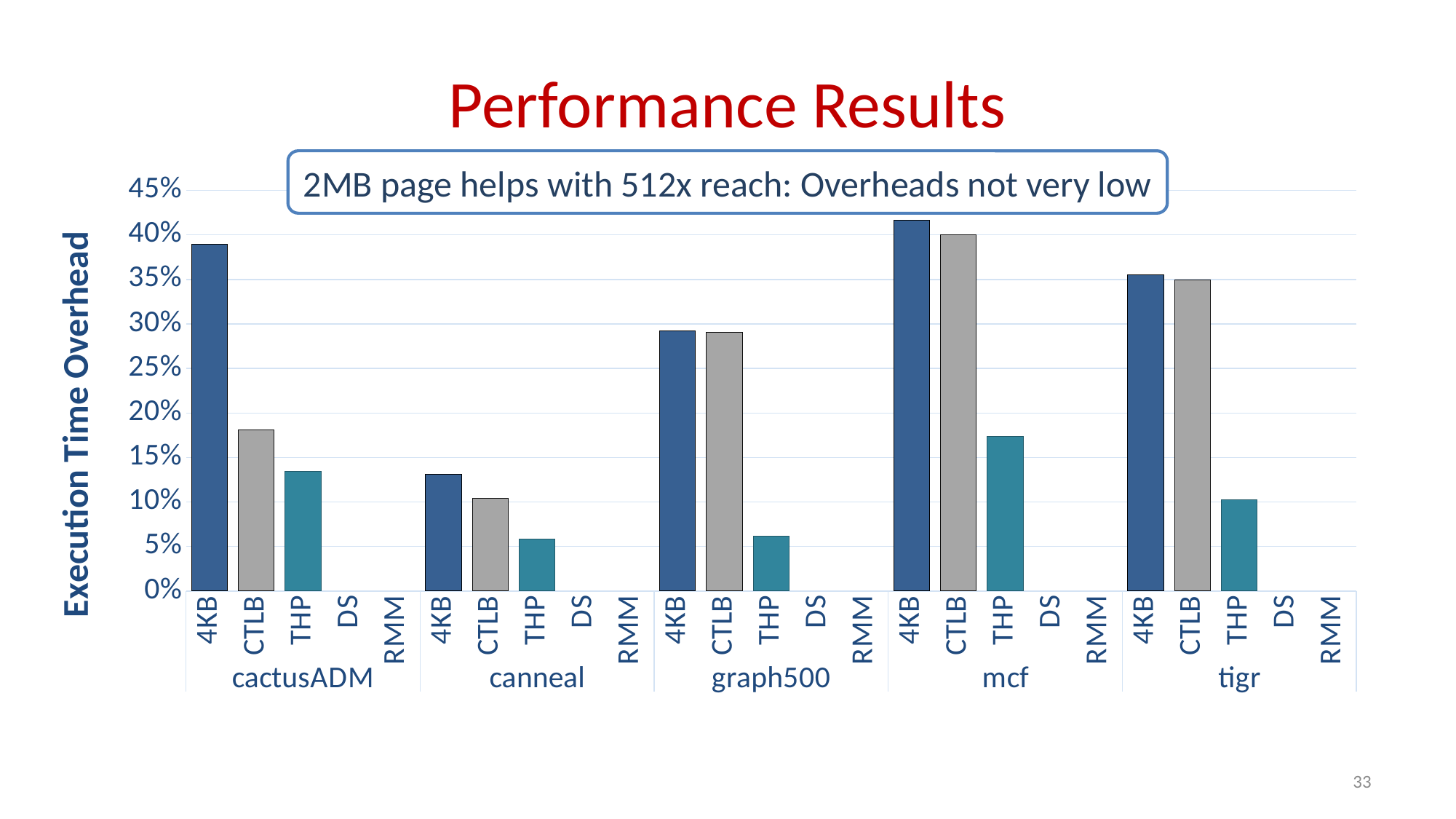
Is the THP value for canneal greater or less than 10%? less Is the CTLB value for tigr greater or less than 30%? greater What is the title of the y axis? Execution Time Overhead Is the 4KB value for cactusADM greater or less than 35%? greater For cactusADM, which is larger: the CTLB bar or the THP bar? CTLB Which benchmark has the highest 4KB bar? mcf Among 4KB, CTLB and THP for mcf, which has the lowest bar? THP What kind of chart is shown on the slide? bar chart Which benchmark has the lowest 4KB bar? canneal How many benchmark groups are shown along the x axis? 5